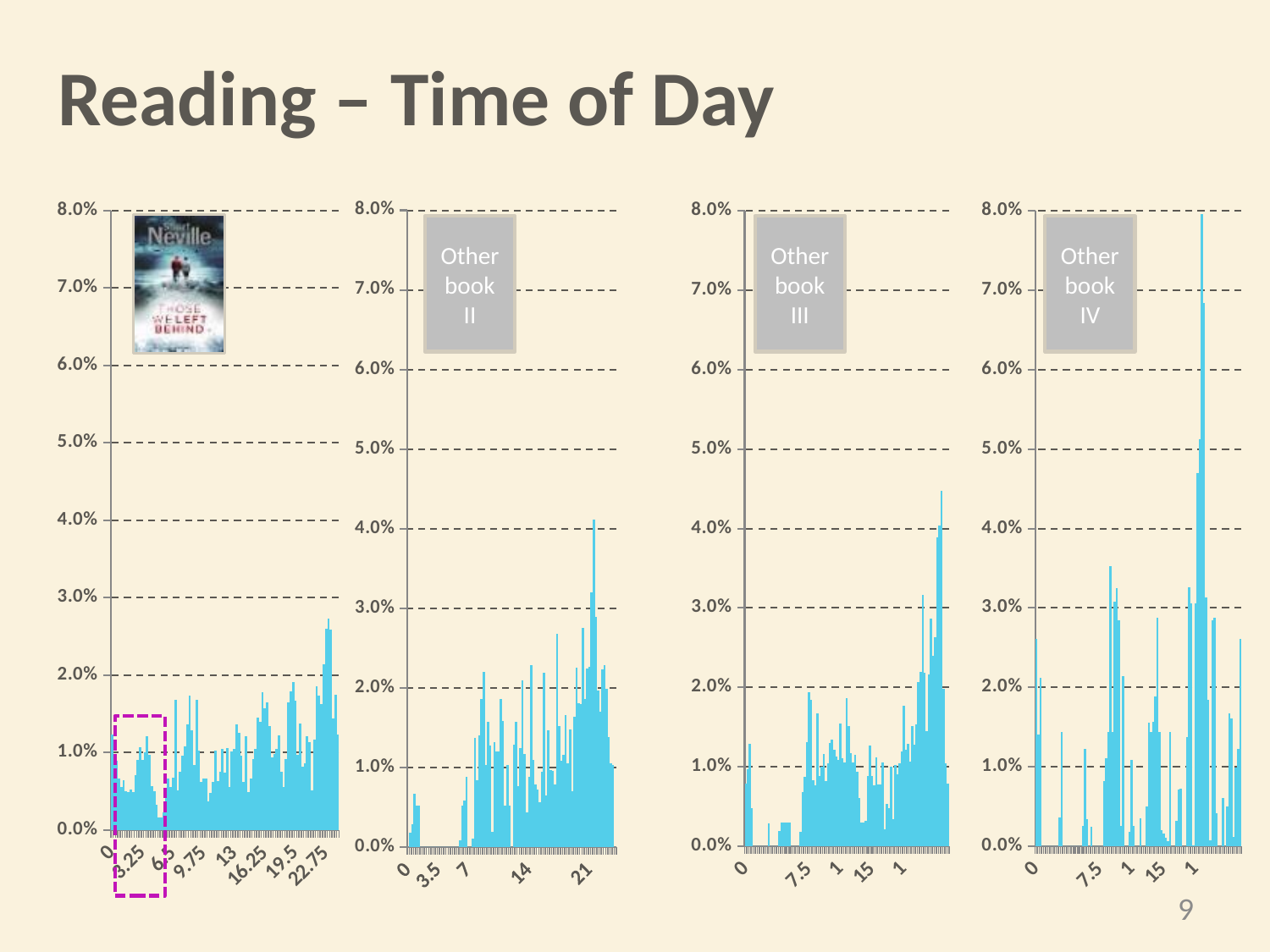
In the rightmost chart (Other book IV), is the tallest bar greater or less than 7.0%? greater Is the peak bar in the Other book IV chart taller or shorter than the peak bar in the Other book II chart? Taller What label is shown in the grey box on the third chart from the left? Other book III What kind of chart is used for each of the four panels on the slide? Bar chart In the third chart from the left (Other book III), is the tallest bar greater or less than 4.0%? greater Which of the four charts has the lowest peak bar? The leftmost chart (the Neville book) How many charts are shown on the slide? 4 In the leftmost chart (the Neville book), is the tallest bar greater or less than 2.0%? greater Which of the four charts has the tallest single bar? Other book IV (rightmost chart) What is the highest value shown on the vertical axis of each chart? 8.0%